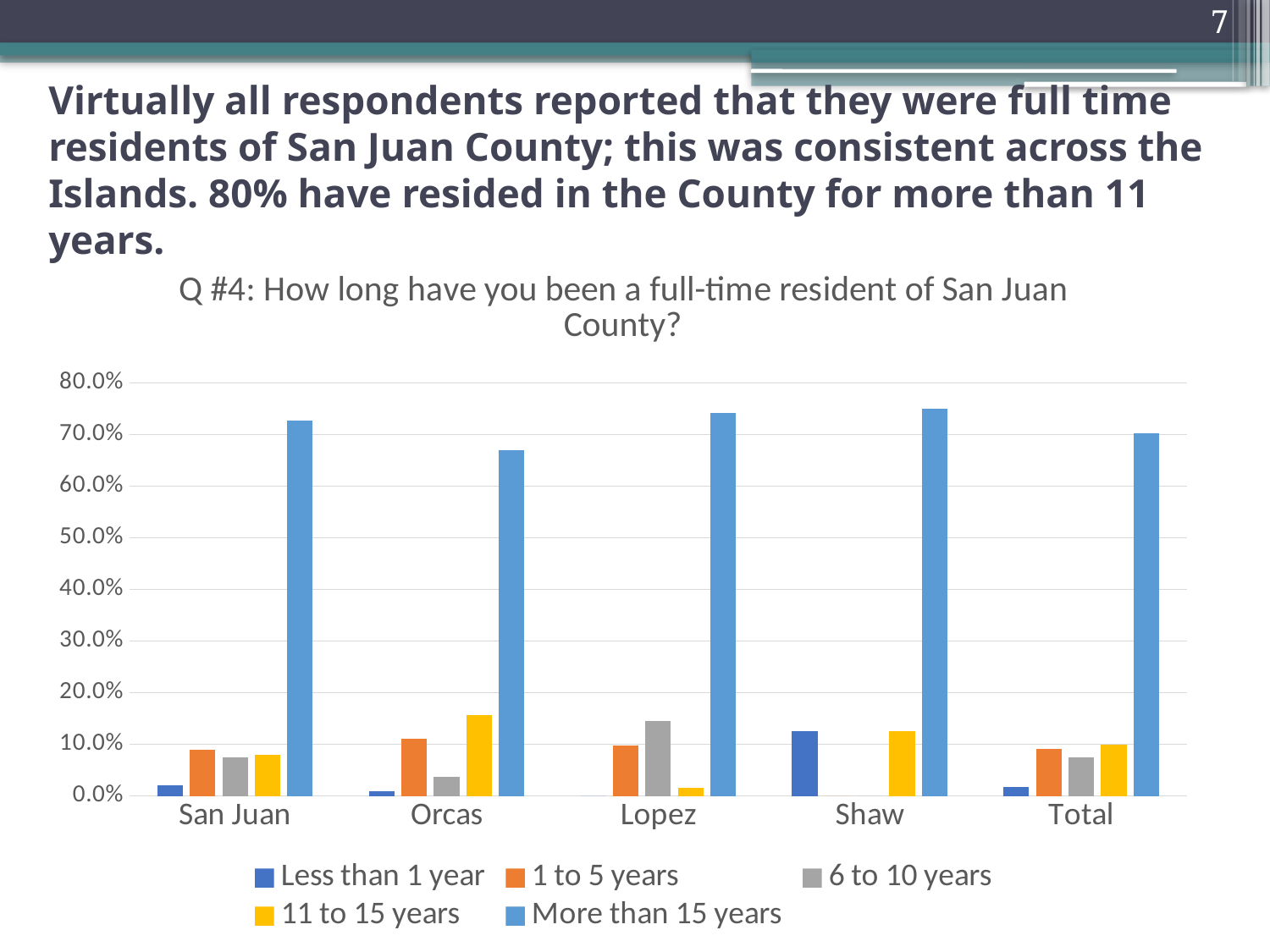
Is the value for 'More than 15 years' for San Juan greater or less than 70.0%? greater Is the value for '6 to 10 years' for Lopez greater or less than 10.0%? greater Is the value for 'More than 15 years' for Orcas greater or less than 70.0%? less Which series has the highest value for Orcas? More than 15 years How many categories are shown along the x axis? 5 What kind of chart is shown on the slide? bar chart What is the title of the chart? Q #4: How long have you been a full-time resident of San Juan County? Which is larger: the '11 to 15 years' value for Orcas or for San Juan? Orcas Which is larger: the 'Less than 1 year' value for Shaw or for San Juan? Shaw Which category has the lowest value for 'More than 15 years'? Orcas How many series does the legend list? 5